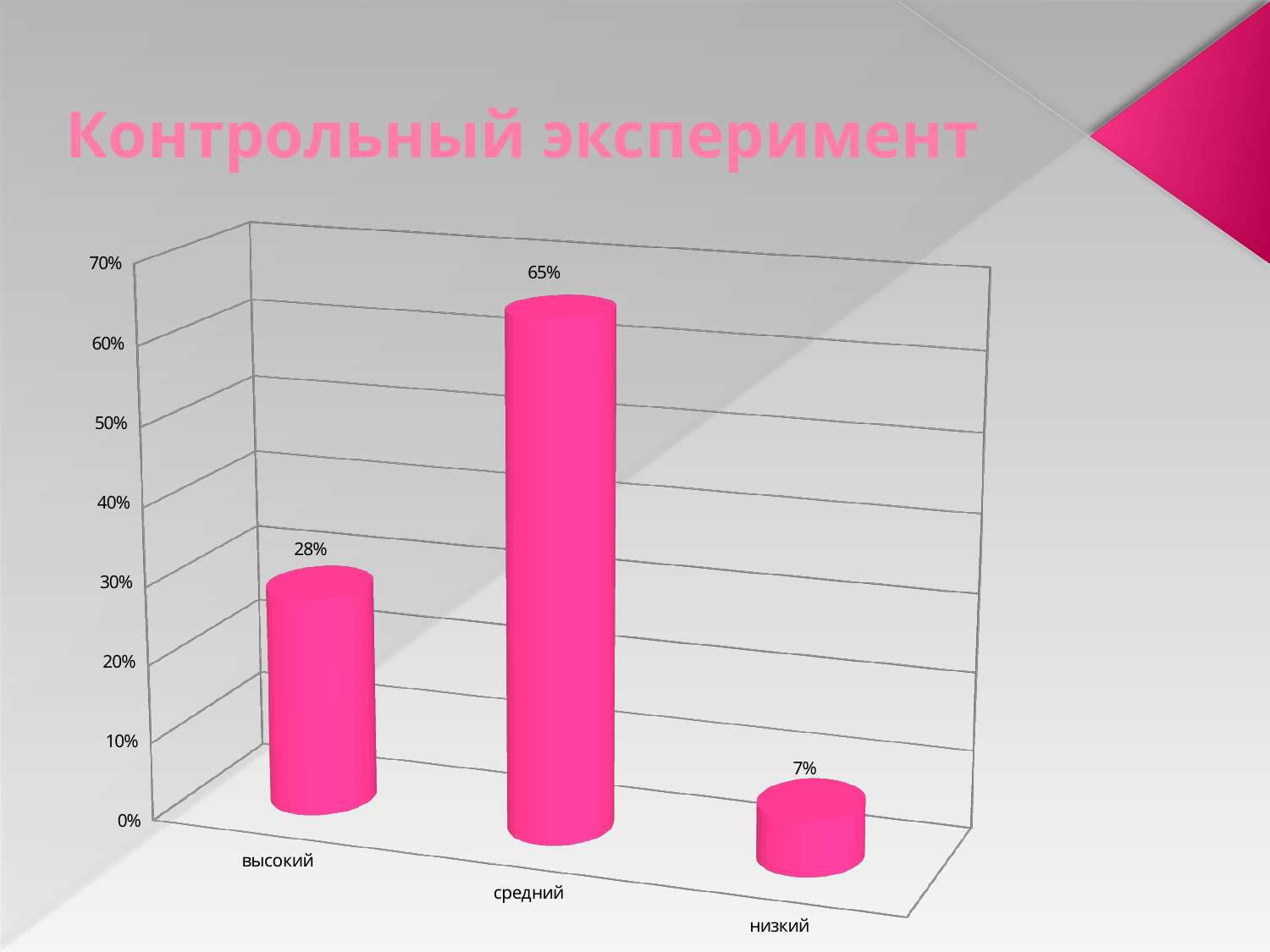
What is the difference between the values for высокий and низкий? 21% Which category has the lowest value? низкий Which category has the highest value? средний What is the difference between the values for средний and высокий? 37% What is the title of the slide? Контрольный эксперимент What kind of chart is shown on the slide? bar chart How many categories are shown on the chart? 3 What is the value for низкий? 7% What is the value for высокий? 28% Which is larger, the value for высокий or the value for низкий? высокий Is the value for средний greater or less than 60%? greater What is the value for средний? 65%